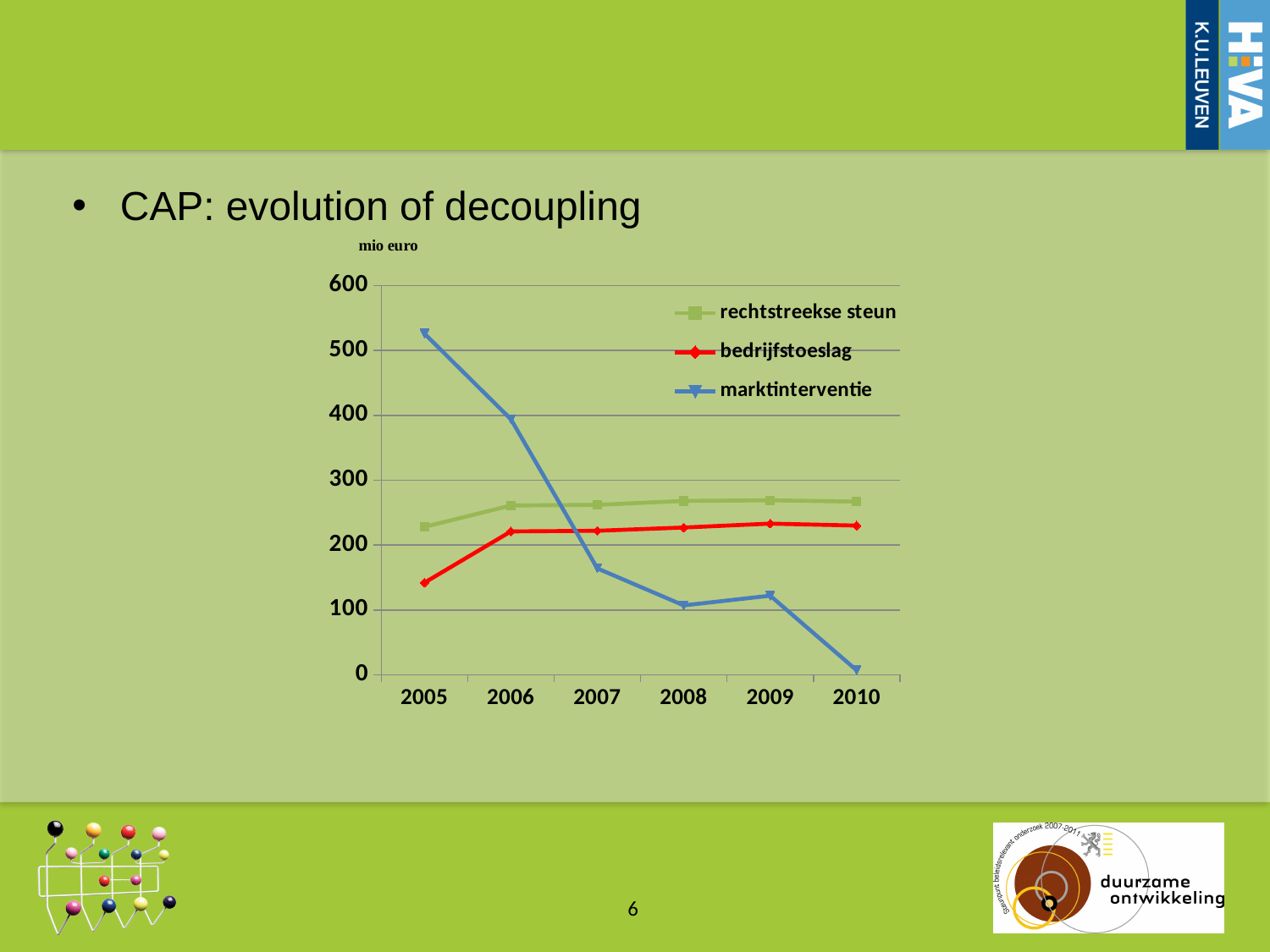
What unit is shown above the y axis of the chart? mio euro In which year is the marktinterventie value highest? 2005 Is the bedrijfstoeslag value for 2005 greater or less than 200? less In 2007, which series has the larger value: rechtstreekse steun or marktinterventie? rechtstreekse steun What kind of chart is shown on the slide? line chart Is the marktinterventie value for 2005 greater or less than 500? greater How many series does the legend list? 3 In which year is the marktinterventie value lowest? 2010 Does the marktinterventie series rise or fall from 2005 to 2010? fall How many years are shown on the x axis? 6 In 2005, which series has the larger value: bedrijfstoeslag or marktinterventie? marktinterventie Is the rechtstreekse steun value for 2008 greater or less than 300? less